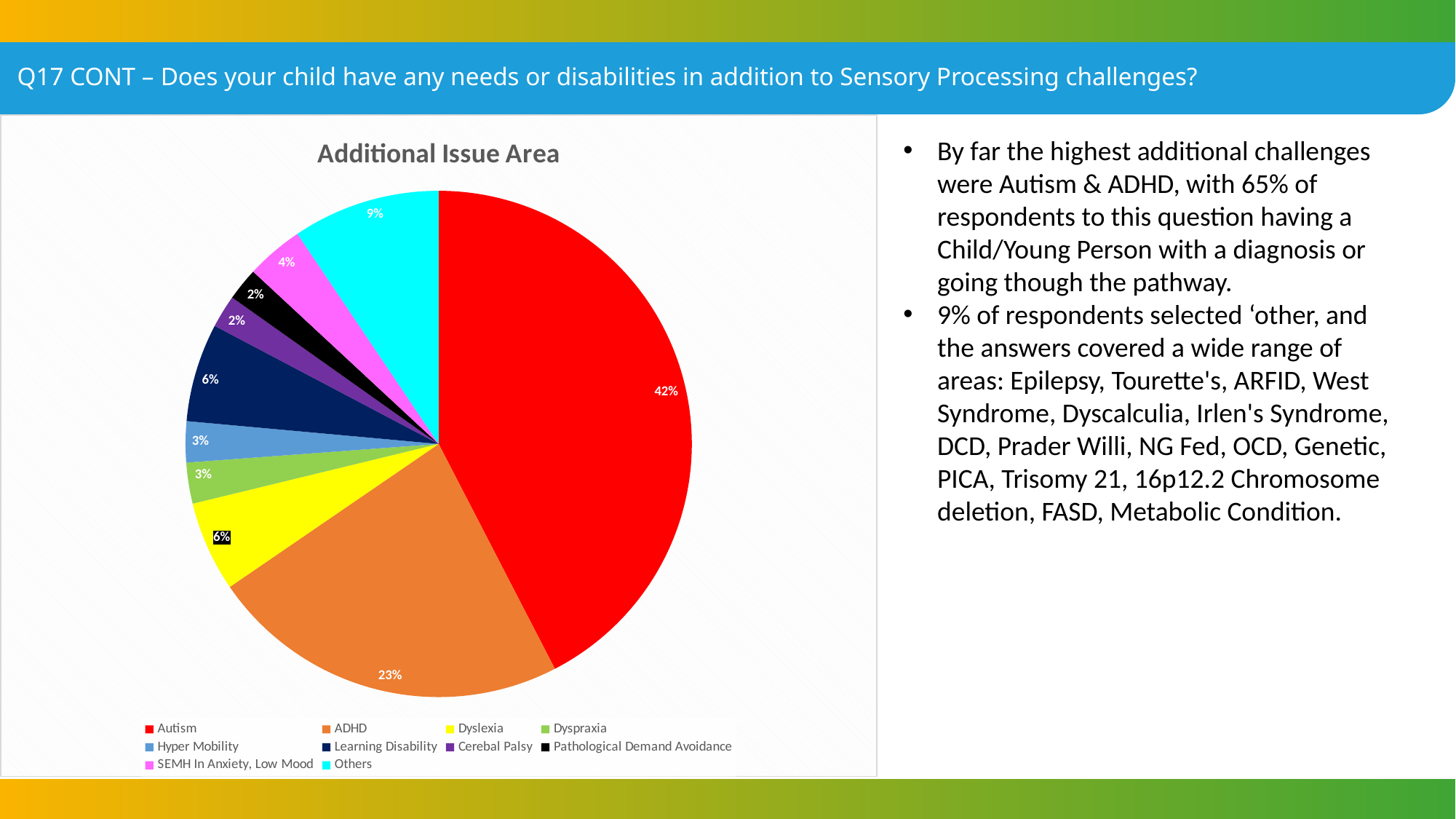
What share of the pie does ADHD represent? 23% What is the difference between the Autism share and the ADHD share? 19% How many categories does the legend list? 10 What share of the pie does Others represent? 9% What share of the pie does Autism represent? 42% What colour is the Autism slice? red Which category has the largest slice of the pie? Autism Which is larger, the share for Others or the share for Dyslexia? Others What is the title of the chart? Additional Issue Area What type of chart is shown on the slide? pie chart